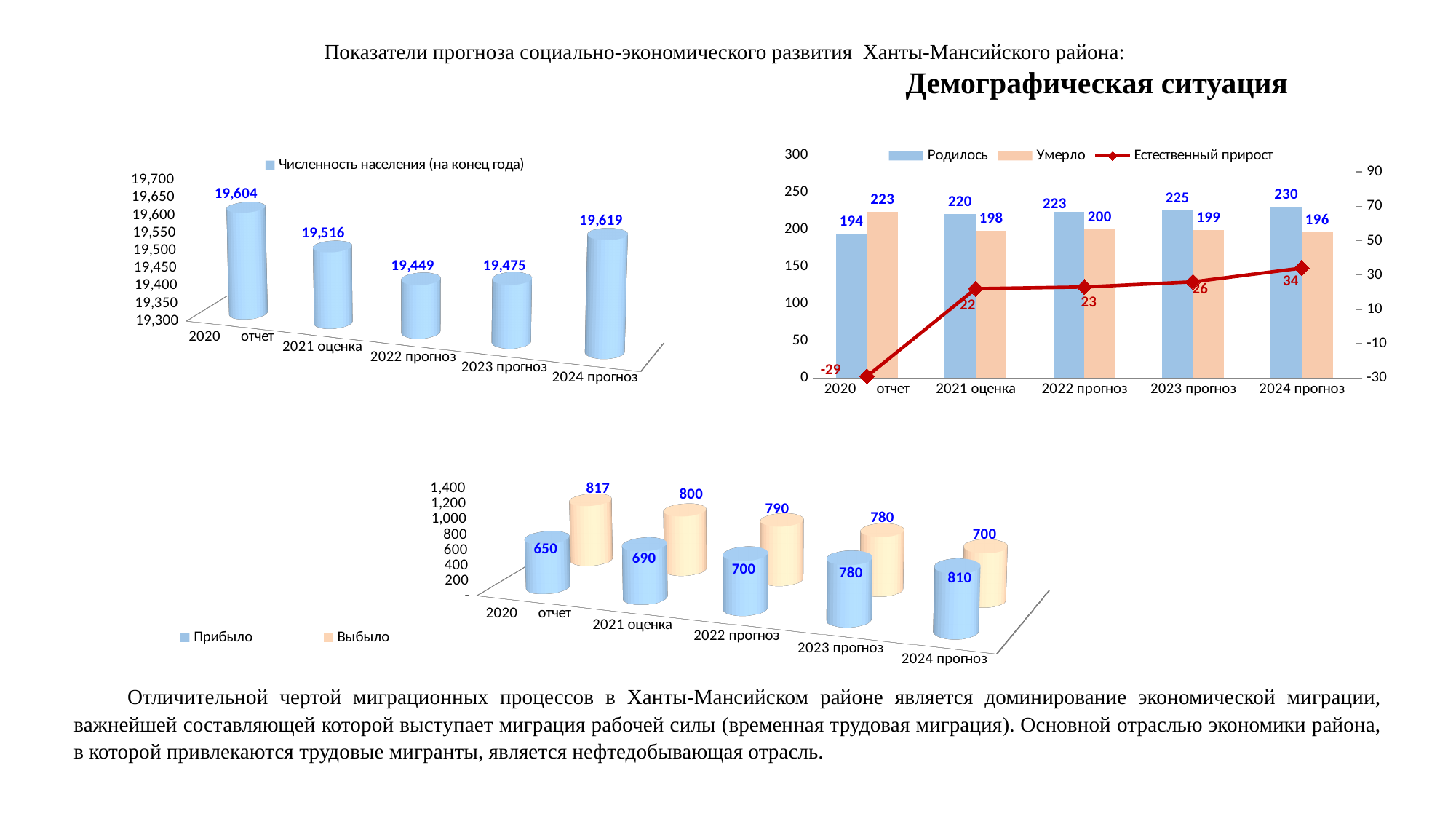
In the top-right chart, does Естественный прирост rise or fall from 2020 отчет to 2024 прогноз? rise In the top-right chart, how many series does the legend list? 3 What type of chart is the bottom chart (Прибыло / Выбыло)? bar chart In the top-right chart, what is the value of Естественный прирост for 2020 отчет? -29 In the top-left chart (Численность населения), what is the difference between the 2024 прогноз and 2023 прогноз values? 144 In the top-left chart (Численность населения), what is the value for 2020 отчет? 19,604 In the top-right chart, what is the value of Родилось for 2024 прогноз? 230 In the top-left chart (Численность населения), how many categories are shown on the x axis? 5 In the top-left chart (Численность населения), which category has the lowest value? 2022 прогноз In the top-right chart, which is larger for 2020 отчет: Родилось or Умерло? Умерло In the bottom chart, what is the value of Выбыло for 2021 оценка? 800 In the bottom chart, what is the difference between Выбыло and Прибыло for 2020 отчет? 167